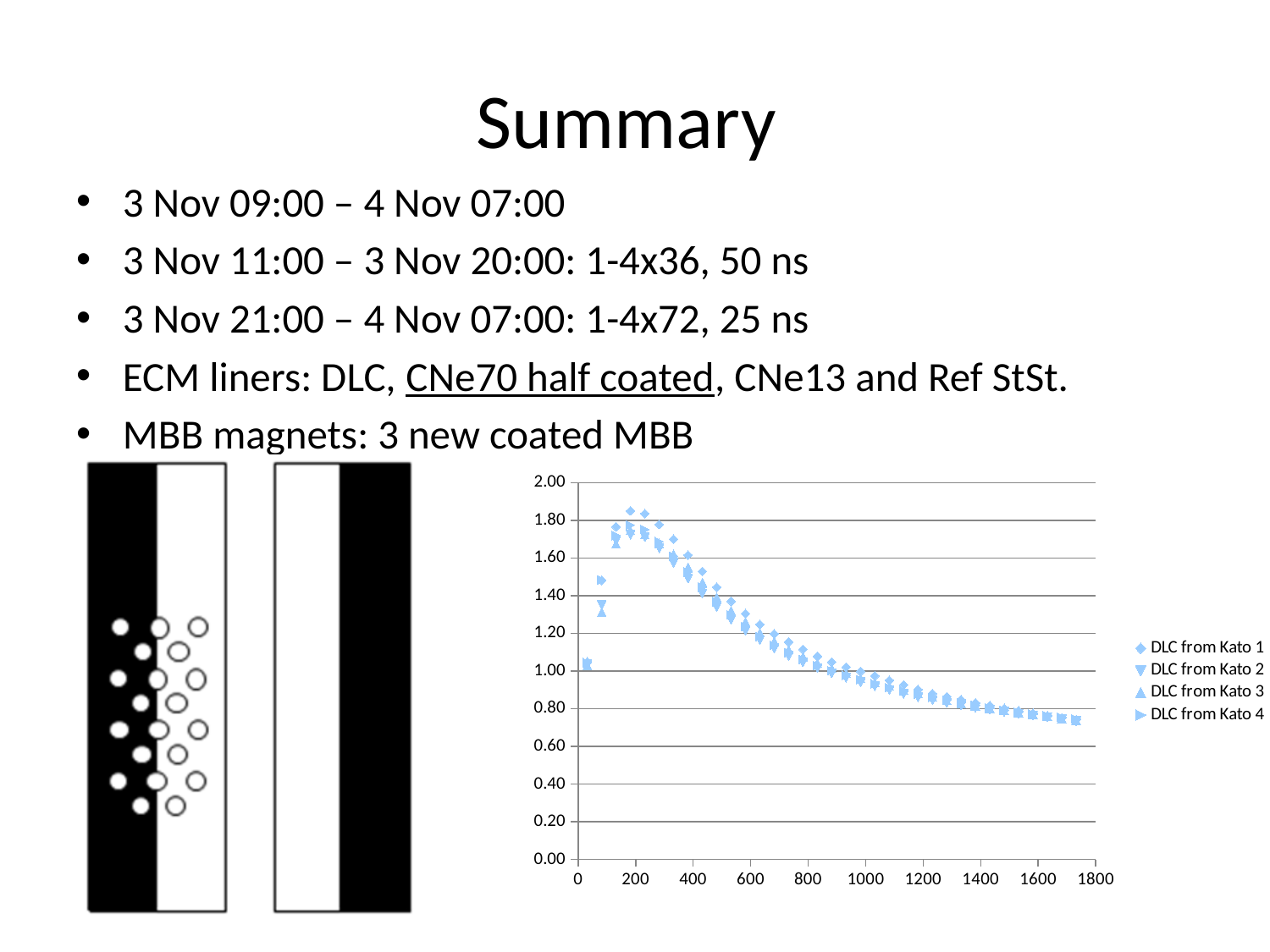
Is the value of the DLC from Kato 1 series at x = 1000 greater or less than 1.20? less Is the value of the DLC from Kato 1 series at x = 1600 greater or less than 1.00? less Do the plotted values rise or fall along the x axis from 400 to 1800? fall What are the names of the series listed in the chart legend? DLC from Kato 1, DLC from Kato 2, DLC from Kato 3, DLC from Kato 4 Is the value of the DLC from Kato 1 series at x = 600 greater or less than 1.20? greater How many series does the legend of the chart list? 4 What kind of chart is shown on the slide? scatter chart Which is larger for the DLC from Kato 1 series: the value at x = 200 or the value at x = 1200? the value at x = 200 What is the highest value shown on the chart's y axis? 2.00